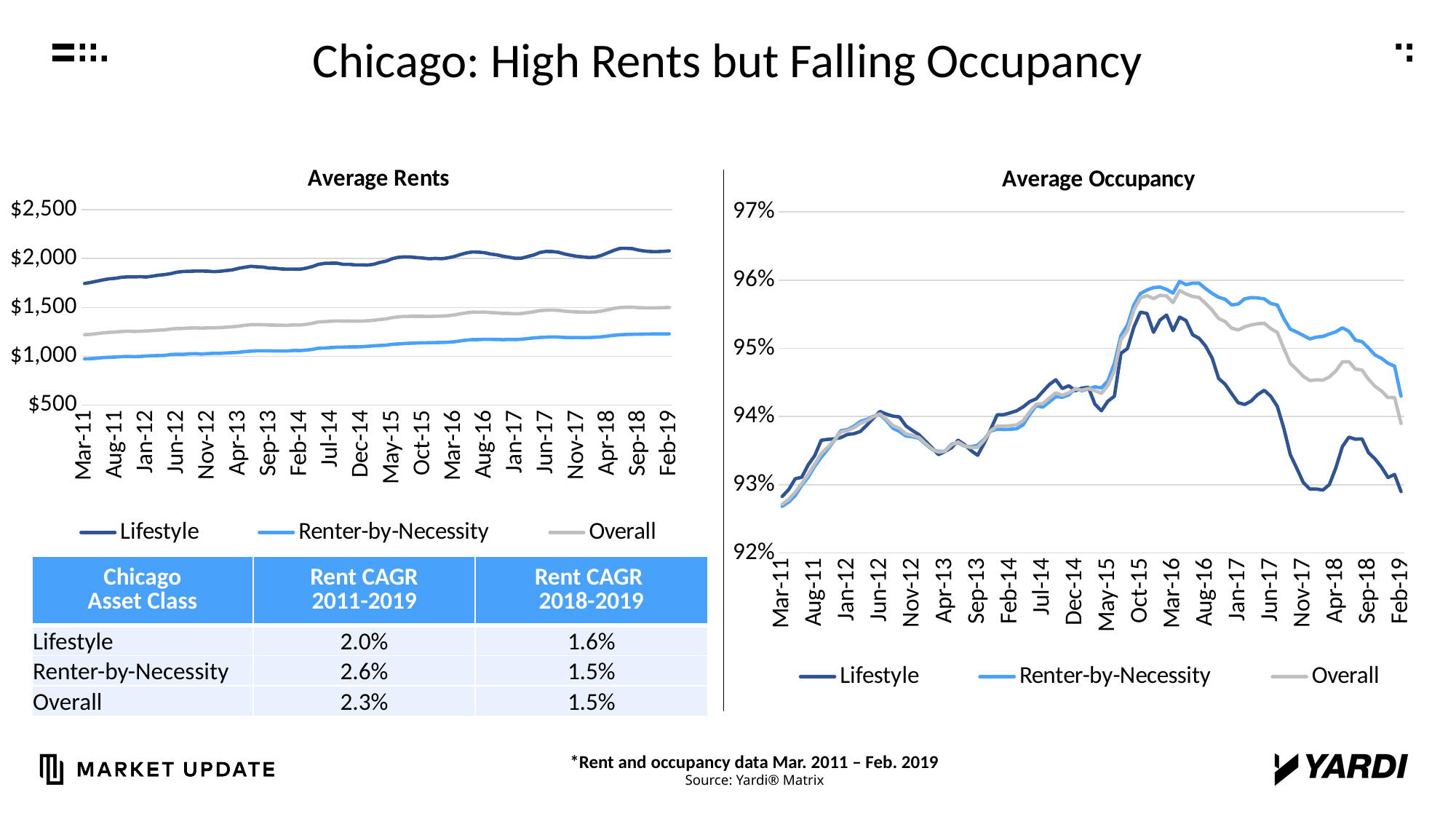
What type of chart is the Average Rents chart? Line chart In the Average Occupancy chart, is the Lifestyle value at Feb-19 greater or less than 94%? less In the Average Rents chart, which series has the highest values across the whole period? Lifestyle In the Average Rents chart, is the Lifestyle value at Feb-19 greater or less than $2,000? greater In the Average Rents chart, is the Renter-by-Necessity value at Feb-19 greater or less than $1,000? greater What type of chart is the Average Occupancy chart? Line chart In the Average Occupancy chart, which series is lowest at Feb-19? Lifestyle In the Average Rents chart, does the Lifestyle series rise or fall from Mar-11 to Feb-19? rise In the Average Occupancy chart, does the Lifestyle series rise or fall from Mar-16 to Feb-19? fall How many series does the legend of the Average Rents chart list? 3